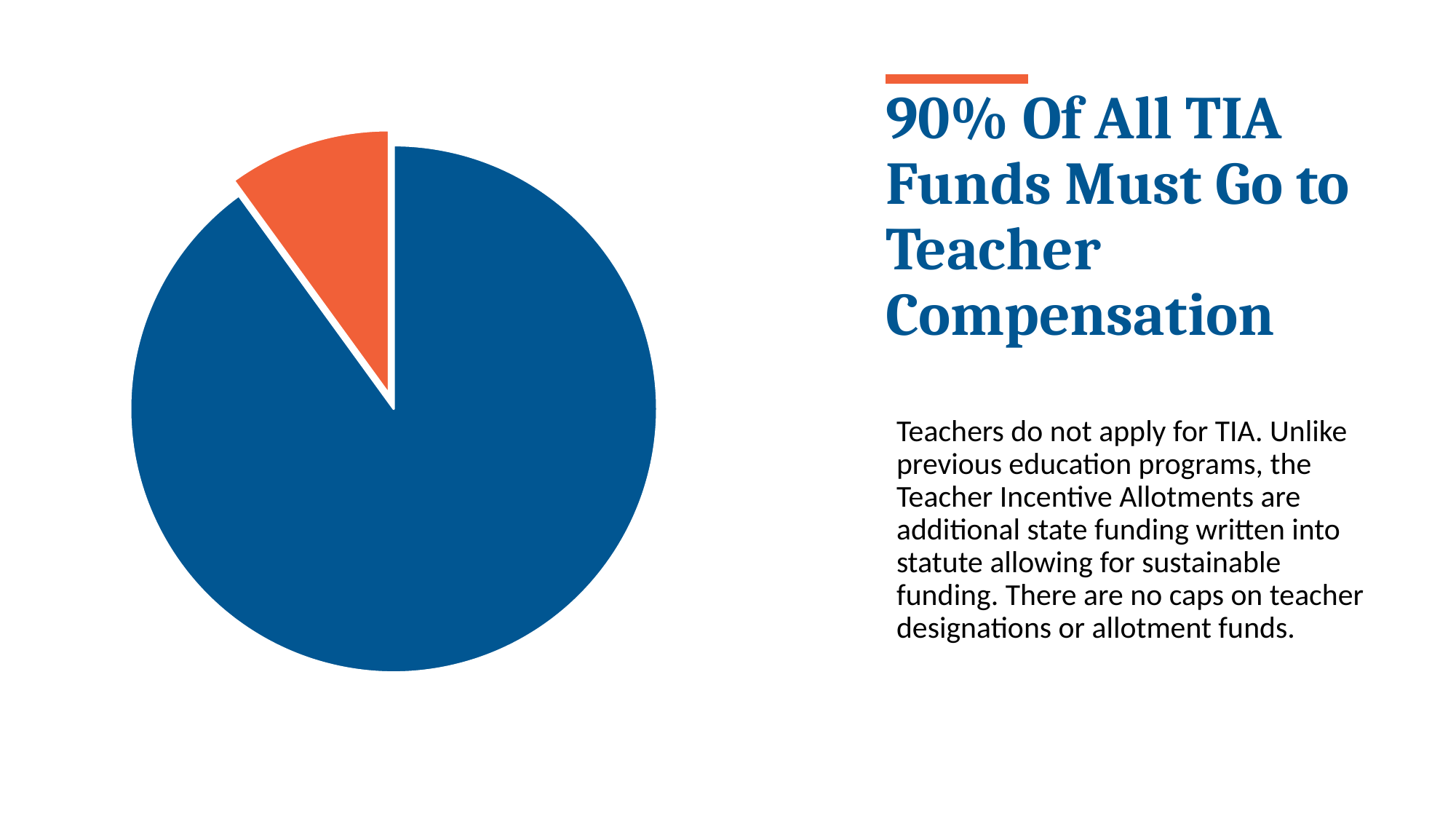
How many slices does the pie chart have? 2 What kind of chart is shown on the slide? pie chart Which colour slice is the smallest in the pie chart? orange What two colours are used for the slices of the pie chart? blue and orange Which slice of the pie chart is larger, the blue one or the orange one? the blue one Which colour slice is the largest in the pie chart? blue According to the slide, what share of all TIA funds must go to teacher compensation, as represented by the large blue slice? 90% Does the pie chart have a legend? No